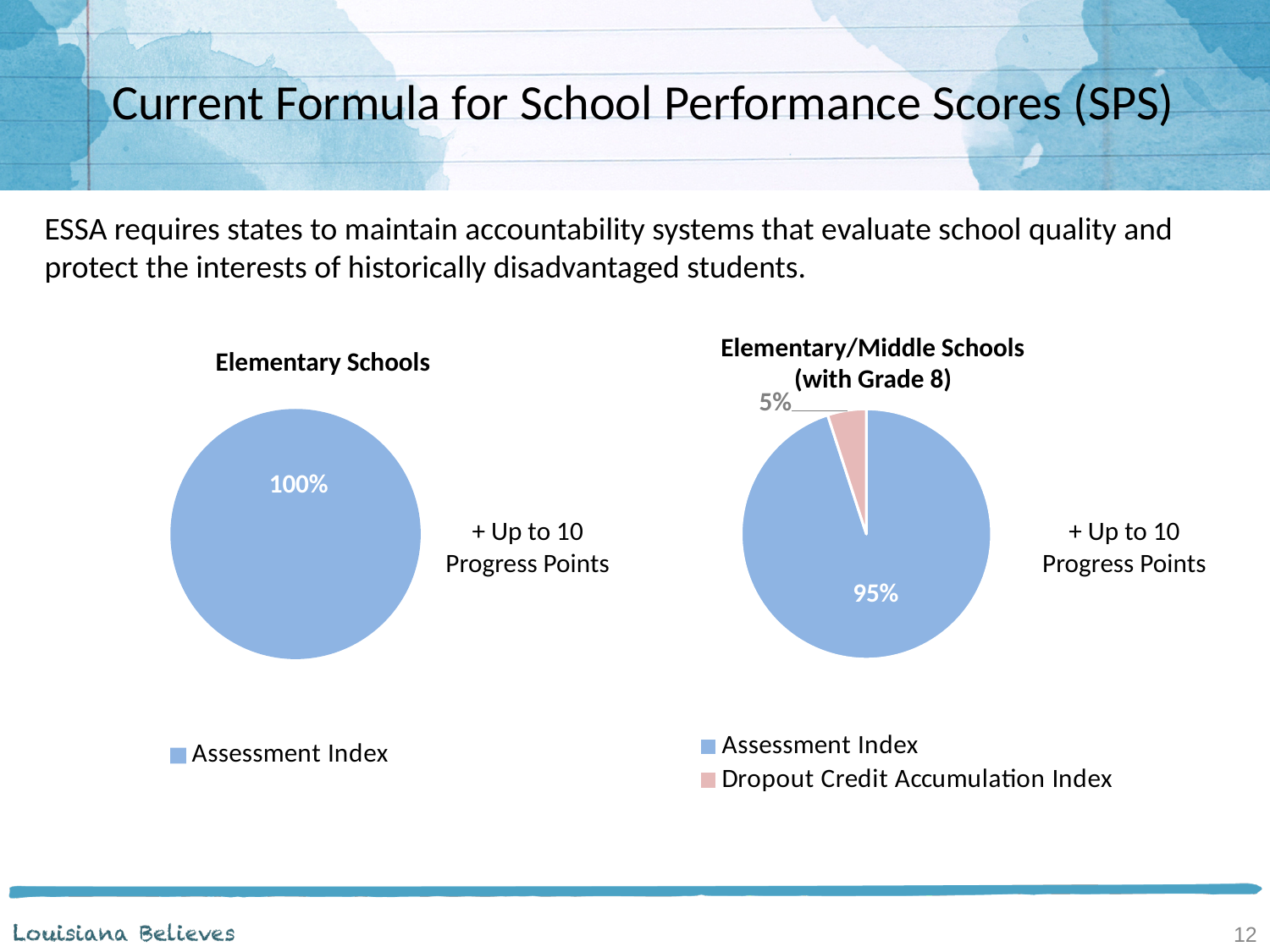
In the "Elementary/Middle Schools (with Grade 8)" chart, what share does the Dropout Credit Accumulation Index have? 5% What kind of chart is the "Elementary Schools" chart? Pie chart In the "Elementary/Middle Schools (with Grade 8)" chart, which slice is the smallest? Dropout Credit Accumulation Index How many entries does the legend of the "Elementary Schools" chart list? 1 In the "Elementary/Middle Schools (with Grade 8)" chart, which is larger: the Assessment Index or the Dropout Credit Accumulation Index? Assessment Index How many entries does the legend of the "Elementary/Middle Schools (with Grade 8)" chart list? 2 In the "Elementary/Middle Schools (with Grade 8)" chart, what colour is the Dropout Credit Accumulation Index slice? Pink In the "Elementary Schools" chart, what share does the Assessment Index have? 100% In the "Elementary/Middle Schools (with Grade 8)" chart, what share does the Assessment Index have? 95% In the "Elementary/Middle Schools (with Grade 8)" chart, which slice is the largest? Assessment Index In the "Elementary/Middle Schools (with Grade 8)" chart, what is the difference between the Assessment Index share and the Dropout Credit Accumulation Index share? 90% How many slices does the "Elementary/Middle Schools (with Grade 8)" chart have? 2